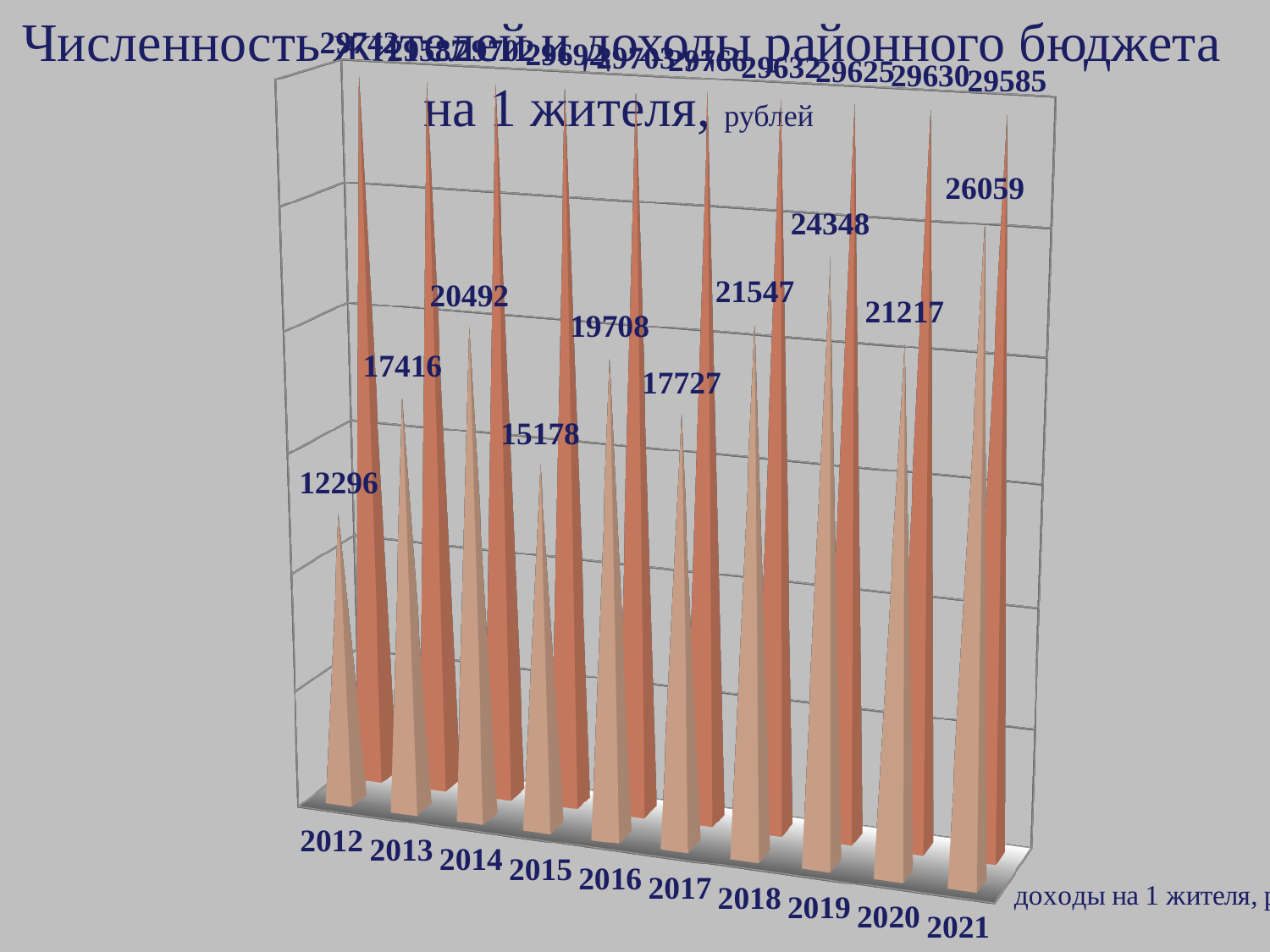
What is the difference between the income per resident in 2021 and in 2012? 13763 What is the income per resident shown for 2021? 26059 How many years are shown on the x axis? 10 In which year is the income per resident the lowest? 2012 What is the income per resident (доходы на 1 жителя) shown for 2012? 12296 What is the difference between the income per resident in 2019 and in 2018? 2801 What is the income per resident shown for 2019? 24348 Does the income per resident rise or fall from 2012 to 2014? rise Which year has a higher income per resident, 2014 or 2015? 2014 In which year is the income per resident the highest? 2021 What is the income per resident shown for 2015? 15178 What kind of chart is shown on the slide? bar chart